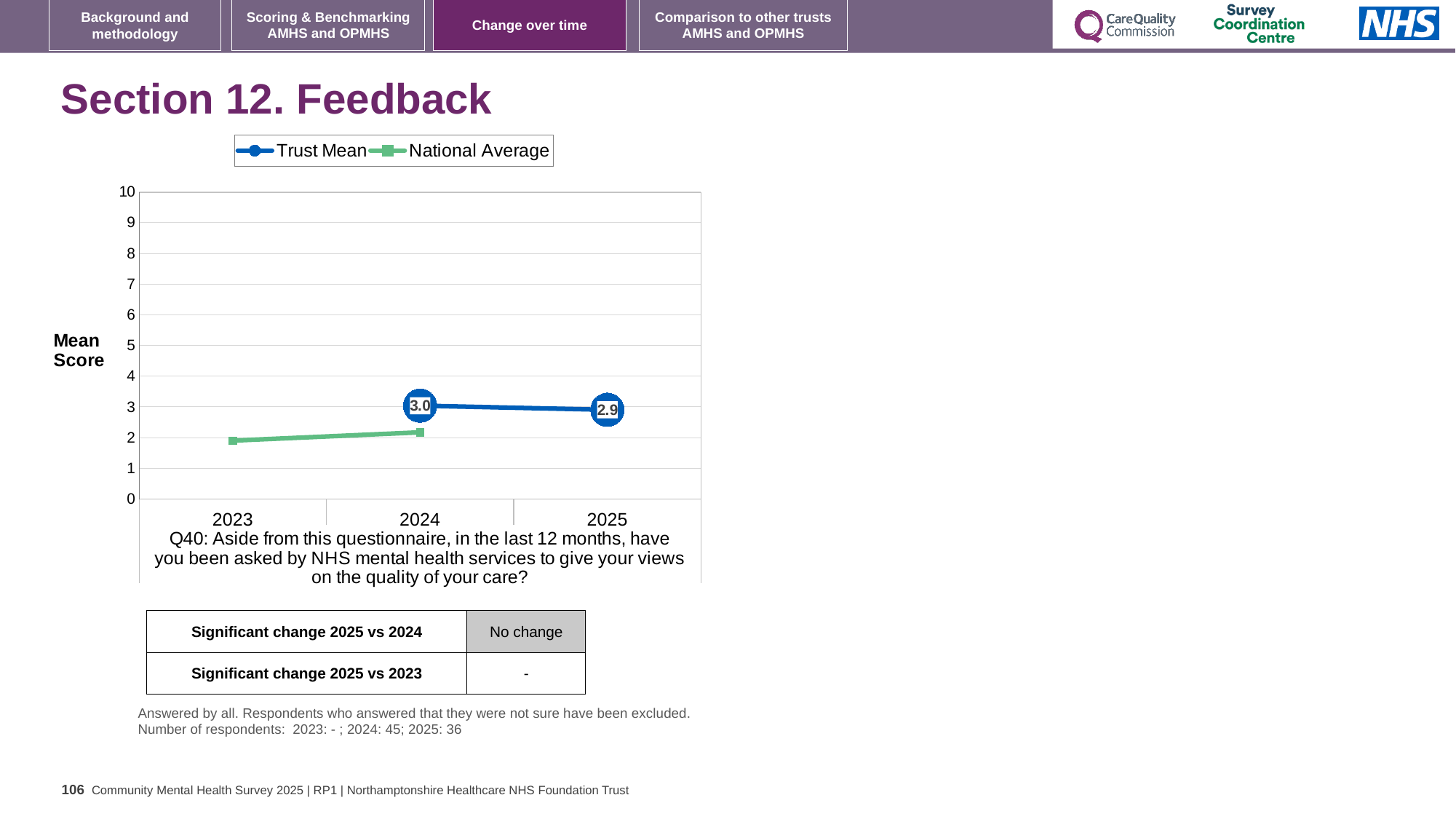
Is the National Average value for 2023 greater or less than 3? less What is the Trust Mean score for 2025? 2.9 How many series does the legend list? 2 What kind of chart is shown on the slide? line chart How many years are shown on the x axis? 3 Which is larger, the Trust Mean score for 2024 or for 2025? 2024 Is the Trust Mean value for 2024 greater or less than the National Average value for 2024? greater What is the label of the y axis? Mean Score What is the difference between the Trust Mean scores for 2024 and 2025? 0.1 Does the Trust Mean rise or fall from 2024 to 2025? fall In which year is the Trust Mean score highest? 2024 What is the Trust Mean score for 2024? 3.0